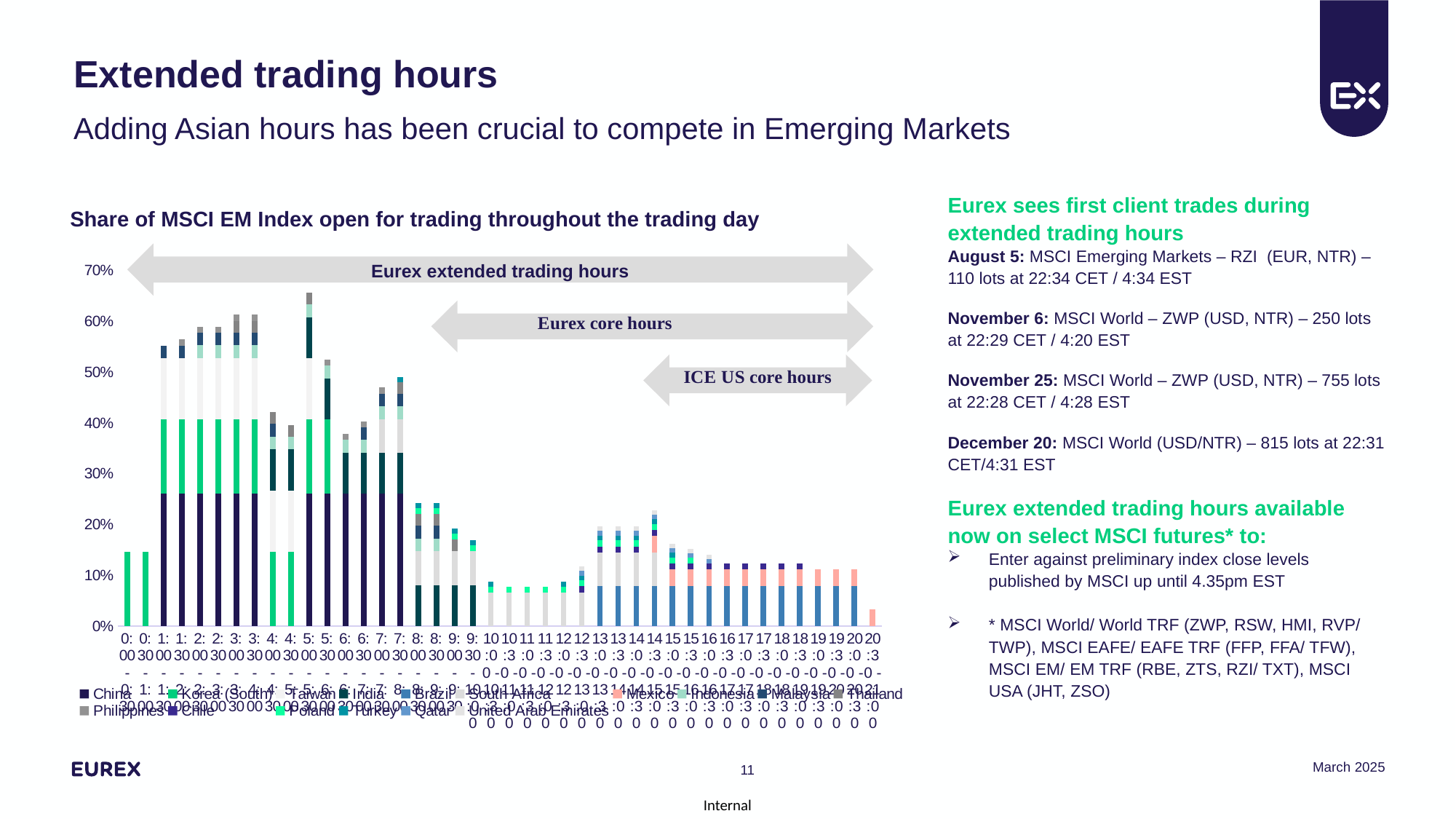
How many series does the chart's legend list? 16 Is the total of the last bar on the right of the chart greater or less than 10%? less What kind of chart is shown on the slide? Stacked bar chart What is the title of the chart? Share of MSCI EM Index open for trading throughout the trading day What is the highest value shown on the chart's vertical axis? 70% Is the total of the first bar on the left of the chart greater or less than 20%? less Is the total of the tallest stacked bar on the chart greater or less than 60%? greater Is the total of the bar at 5:00 greater or less than the total of the bar at 10:00? greater Overall, do the stacked bar totals rise or fall moving from left to right along the x axis? fall